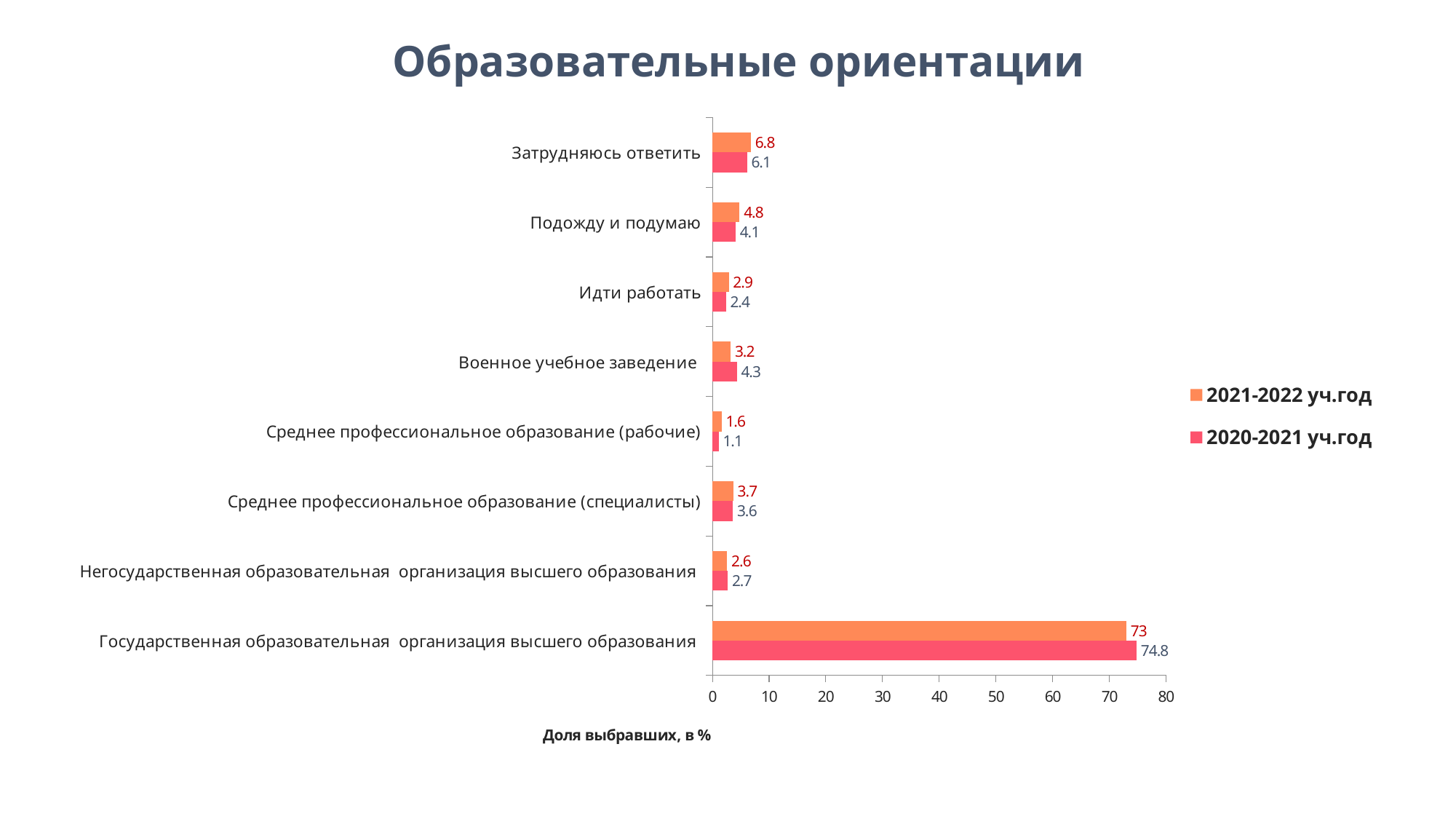
Which category has the lowest value in the 2020-2021 уч.год series? Среднее профессиональное образование (рабочие) What is the difference between the 2020-2021 уч.год and 2021-2022 уч.год values for "Государственная образовательная организация высшего образования"? 1.8 What is the title of the chart? Образовательные ориентации Is the 2020-2021 уч.год value for "Государственная образовательная организация высшего образования" greater or less than 70? greater What kind of chart is shown on the slide? bar chart What is the value for "Государственная образовательная организация высшего образования" in the 2021-2022 уч.год series? 73 What is the value for "Военное учебное заведение" in the 2020-2021 уч.год series? 4.3 Which category has the highest value in the 2020-2021 уч.год series? Государственная образовательная организация высшего образования What is the value for "Затрудняюсь ответить" in the 2021-2022 уч.год series? 6.8 How many series does the legend list? 2 How many categories are shown on the chart? 8 Which is larger for "Военное учебное заведение": the 2021-2022 уч.год value or the 2020-2021 уч.год value? 2020-2021 уч.год